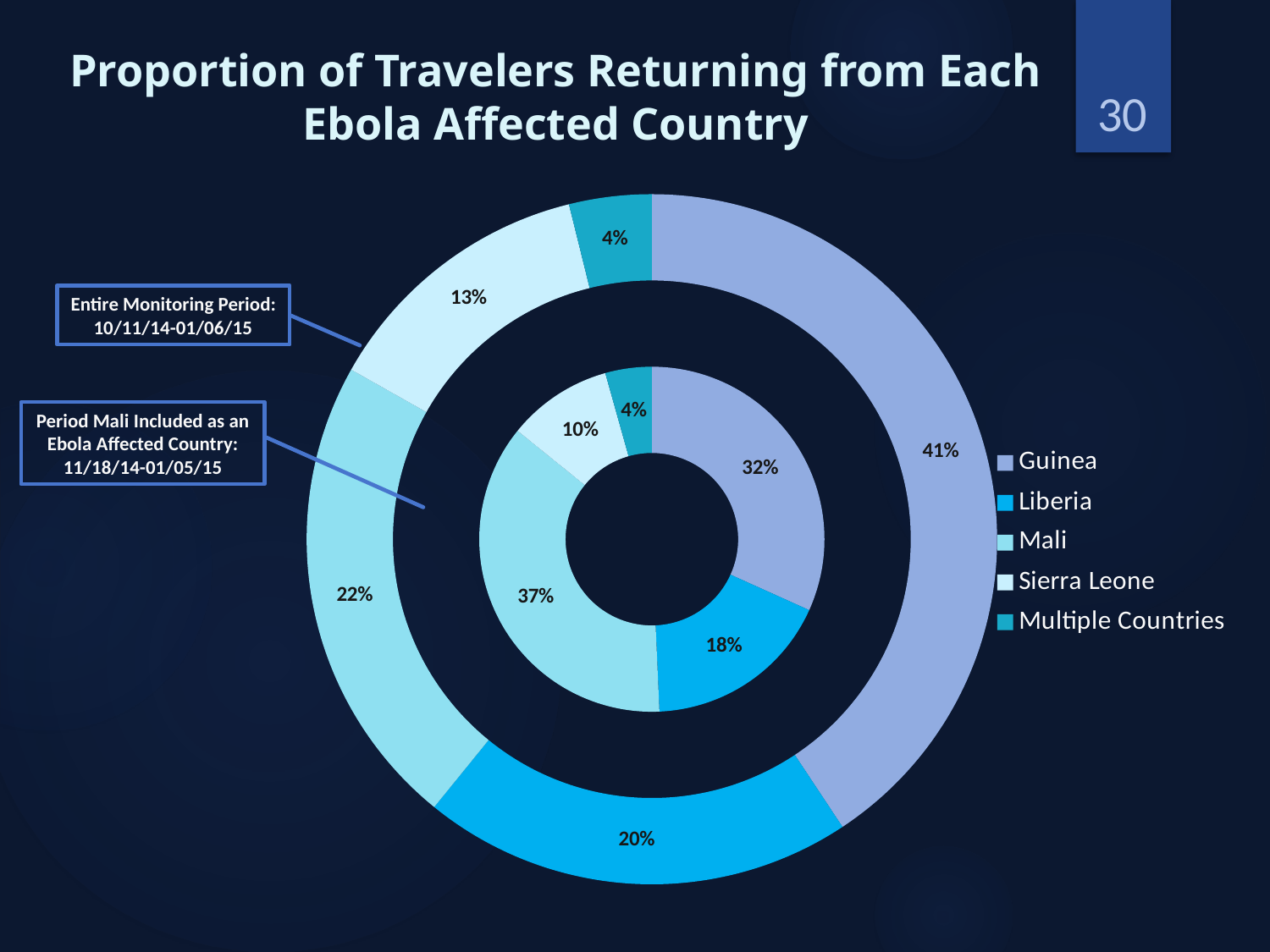
In the outer ring (Entire Monitoring Period), what share of travelers returned from Mali? 22% In the inner ring (Period Mali Included as an Ebola Affected Country), which category has the largest share? Mali In the outer ring (Entire Monitoring Period), which country has the largest share? Guinea What date range does the Entire Monitoring Period cover, according to the callout? 10/11/14-01/06/15 In the outer ring (Entire Monitoring Period), which category has the smallest share? Multiple Countries What kind of chart is shown on the slide? Doughnut chart In the inner ring (Period Mali Included as an Ebola Affected Country), what share of travelers returned from Mali? 37% In the outer ring (Entire Monitoring Period), what share of travelers returned from Guinea? 41% In the inner ring (Period Mali Included as an Ebola Affected Country), what share of travelers returned from Liberia? 18% In the outer ring (Entire Monitoring Period), which is larger: the share for Liberia or the share for Sierra Leone? Liberia How many categories does the legend list? 5 What is the difference between the Guinea share in the outer ring (41%) and the Guinea share in the inner ring (32%)? 9%